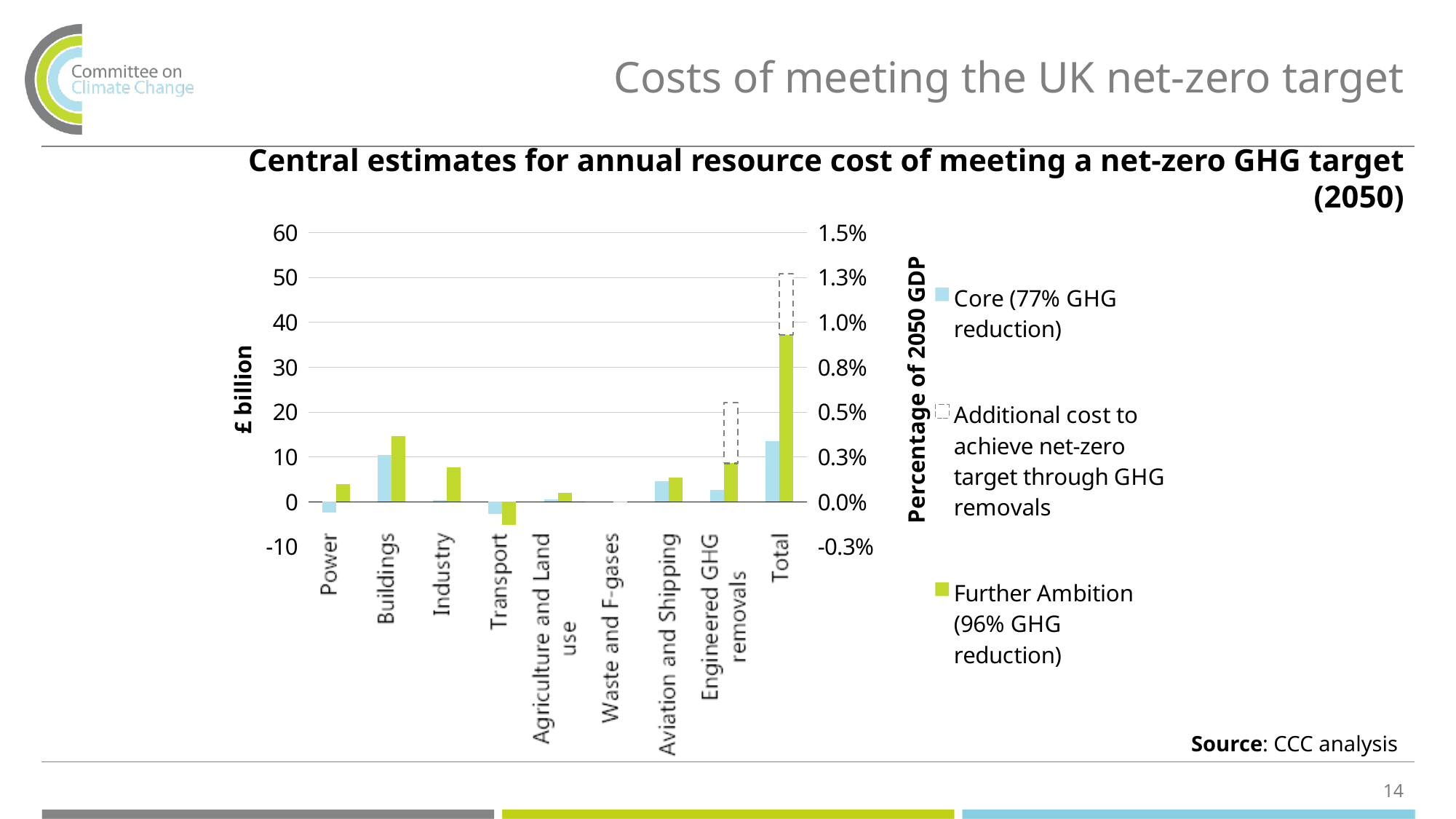
What is the label of the left vertical axis? £ billion Is the Further Ambition (96% GHG reduction) value for Buildings greater or less than 10 £ billion? greater Which category has the lowest Further Ambition (96% GHG reduction) value? Transport Is the Core (77% GHG reduction) value for Total greater or less than 20 £ billion? less Is the Further Ambition (96% GHG reduction) value for Transport greater or less than 0? less Which is larger: the Further Ambition (96% GHG reduction) value for Buildings or for Aviation and Shipping? Buildings Which category has the highest Further Ambition (96% GHG reduction) value? Total What kind of chart is shown on the slide? Bar chart What is the label of the right vertical axis? Percentage of 2050 GDP How many categories are shown along the x axis of the chart? 9 How many series does the chart's legend list? 3